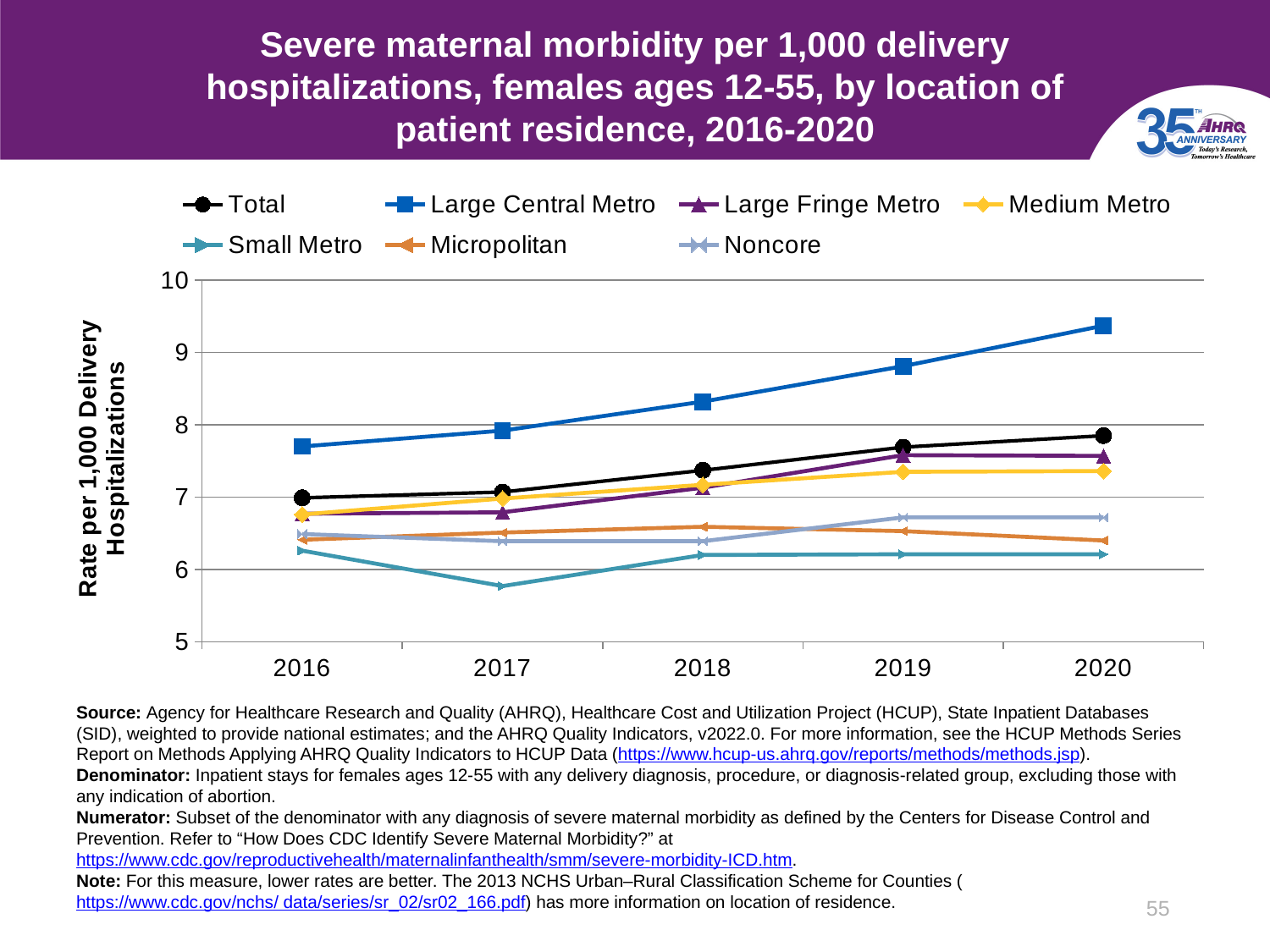
How many years are plotted along the x axis? 5 Is the value for Total in 2016 greater or less than 8? less Which series has the lowest value in 2017? Small Metro How many series does the legend list? 7 Is the value for Small Metro in 2017 greater or less than 6? less Is the value for Large Central Metro in 2020 greater or less than 9? greater In 2019, which is larger: the value for Total or the value for Medium Metro? Total Which series has the highest value in 2020? Large Central Metro Does the Large Central Metro line rise or fall from 2016 to 2020? rises What is the title of the y axis? Rate per 1,000 Delivery Hospitalizations What kind of chart is shown on the slide? line chart What colour is the Large Central Metro line in the legend? blue